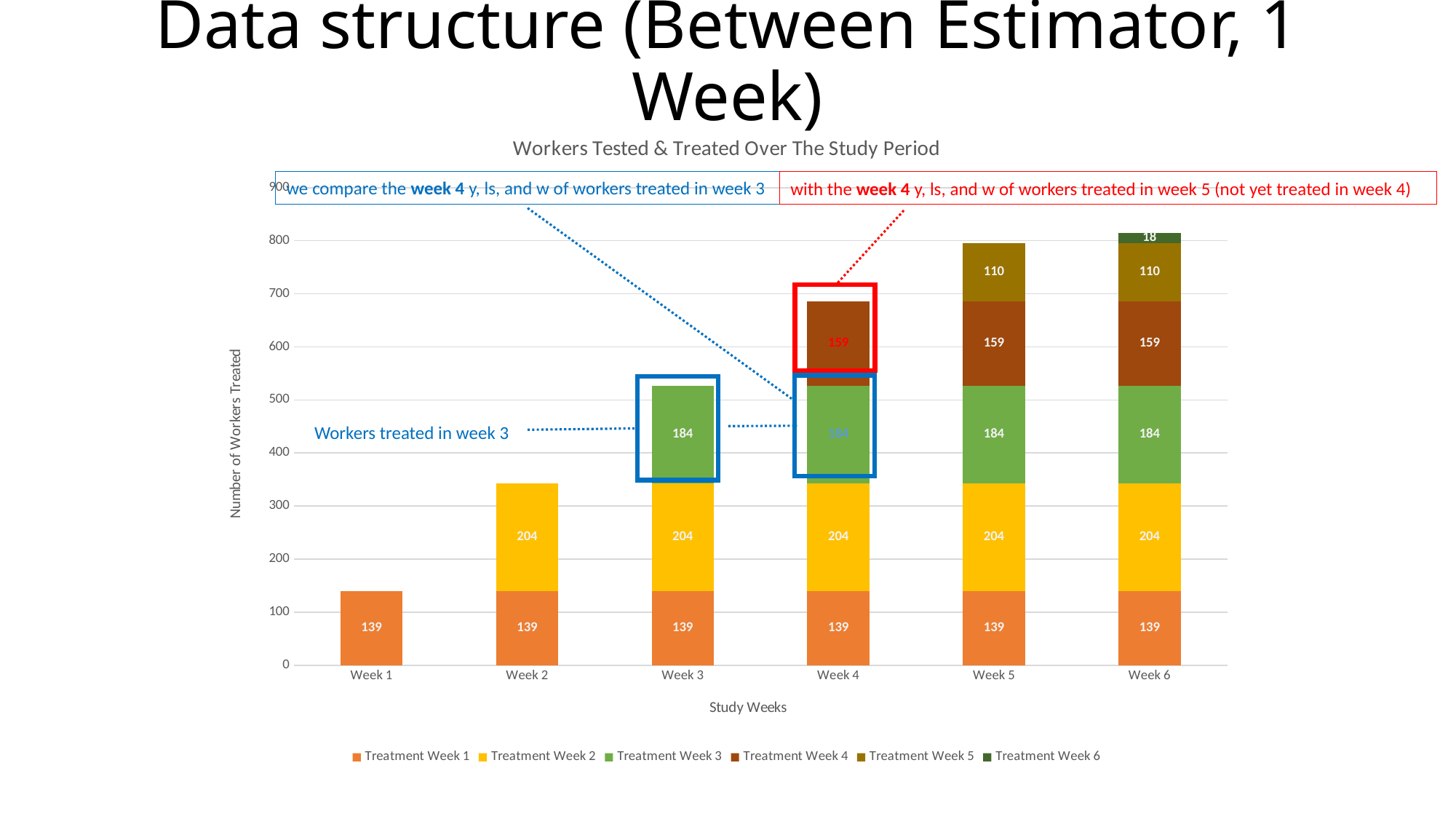
How many study weeks are shown on the x axis? 6 What type of chart is shown on the slide? Stacked bar chart What is the total of the stacked bar for Week 3? 527 What is the difference between the Treatment Week 2 segment and the Treatment Week 1 segment in the Week 2 bar? 65 What is the value of the Treatment Week 6 segment in the Week 6 bar? 18 What is the value of the Treatment Week 4 segment in the Week 5 bar? 159 Which study week has the lowest total number of workers treated? Week 1 What is the value of the Treatment Week 2 segment in the Week 4 bar? 204 What is the total of the stacked bar for Week 4? 686 What is the title of the chart? Workers Tested & Treated Over The Study Period How many series does the legend list? 6 Is the total for the Week 5 bar greater or less than 700? greater